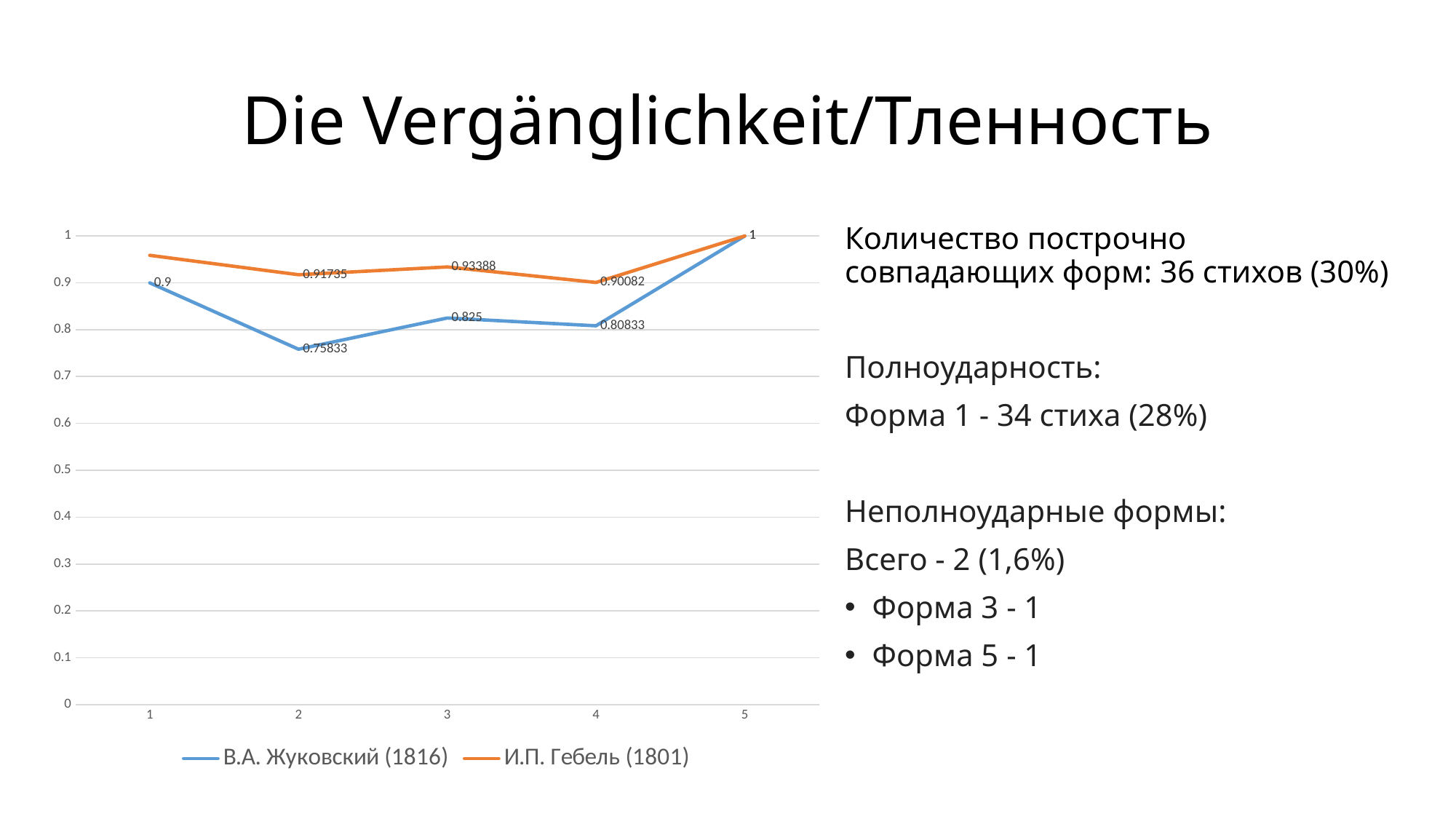
What is the value for В.А. Жуковский (1816) at point 2? 0.75833 What is the value for В.А. Жуковский (1816) at point 1? 0.9 Is the value for И.П. Гебель (1801) at point 1 greater or less than 0.9? greater How many points are plotted along the x axis for each series? 5 What kind of chart is shown on the slide? line chart Does the value for В.А. Жуковский (1816) rise or fall from point 4 to point 5? rise Which series is drawn in orange in the chart? И.П. Гебель (1801) At which point does В.А. Жуковский (1816) reach its lowest value? 2 What is the value for И.П. Гебель (1801) at point 3? 0.93388 How many series does the chart legend list? 2 What is the value for И.П. Гебель (1801) at point 4? 0.90082 Which series has the higher value at point 2, В.А. Жуковский (1816) or И.П. Гебель (1801)? И.П. Гебель (1801)